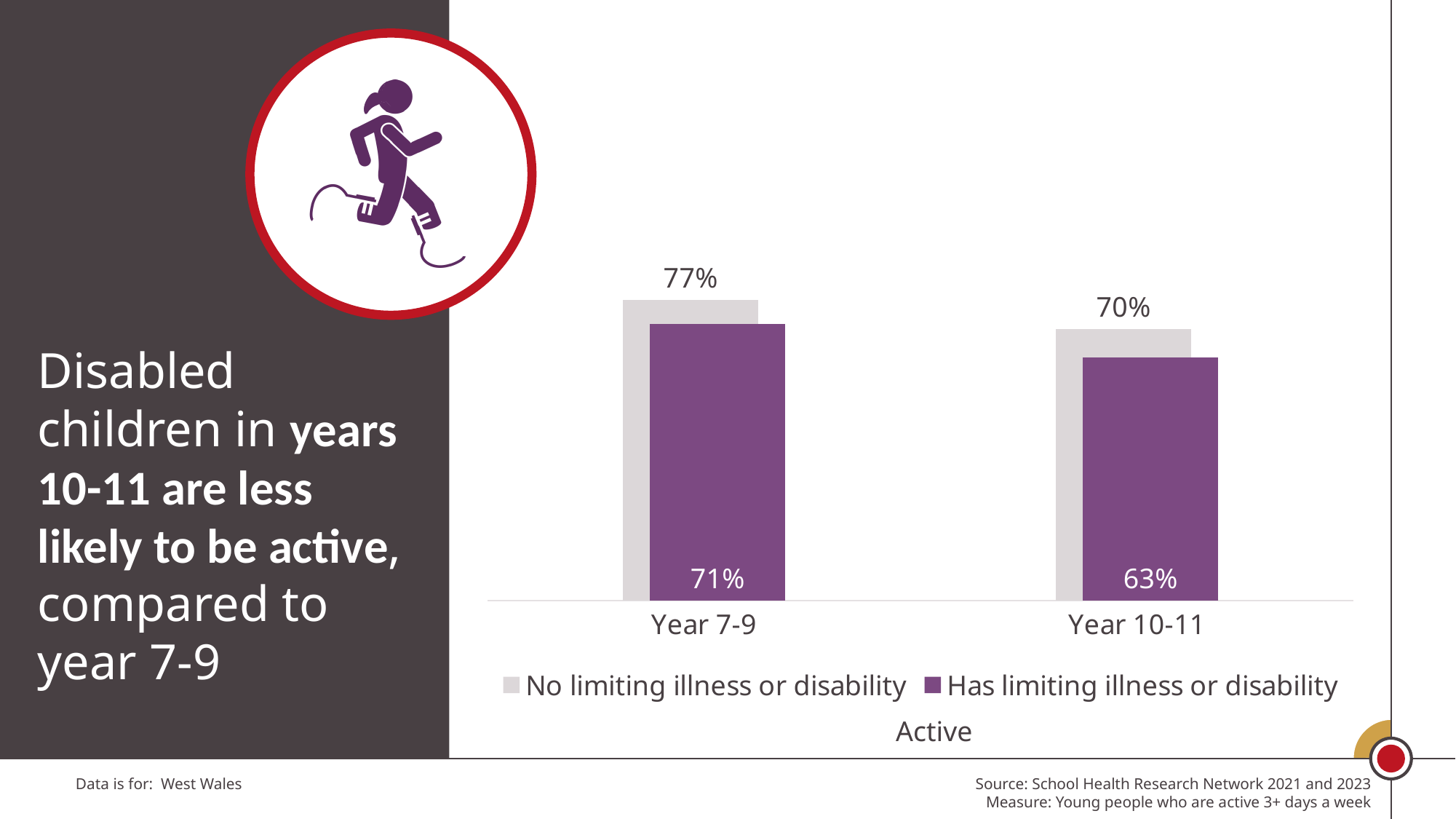
How many series does the legend list? 2 What is the value for 'Has limiting illness or disability' in Year 7-9? 71% Which is larger: 'Has limiting illness or disability' in Year 7-9 or 'No limiting illness or disability' in Year 10-11? Has limiting illness or disability in Year 7-9 What is the value for 'No limiting illness or disability' in Year 10-11? 70% Which category has the highest value for 'No limiting illness or disability'? Year 7-9 Which category has the lowest value for 'Has limiting illness or disability'? Year 10-11 What is the difference between the 'Has limiting illness or disability' values for Year 7-9 and Year 10-11? 8% What kind of chart is shown? Bar chart What is the value for 'No limiting illness or disability' in Year 7-9? 77% What is the value for 'Has limiting illness or disability' in Year 10-11? 63% What is the difference between 'No limiting illness or disability' and 'Has limiting illness or disability' in Year 10-11? 7% How many categories are shown on the x axis? 2